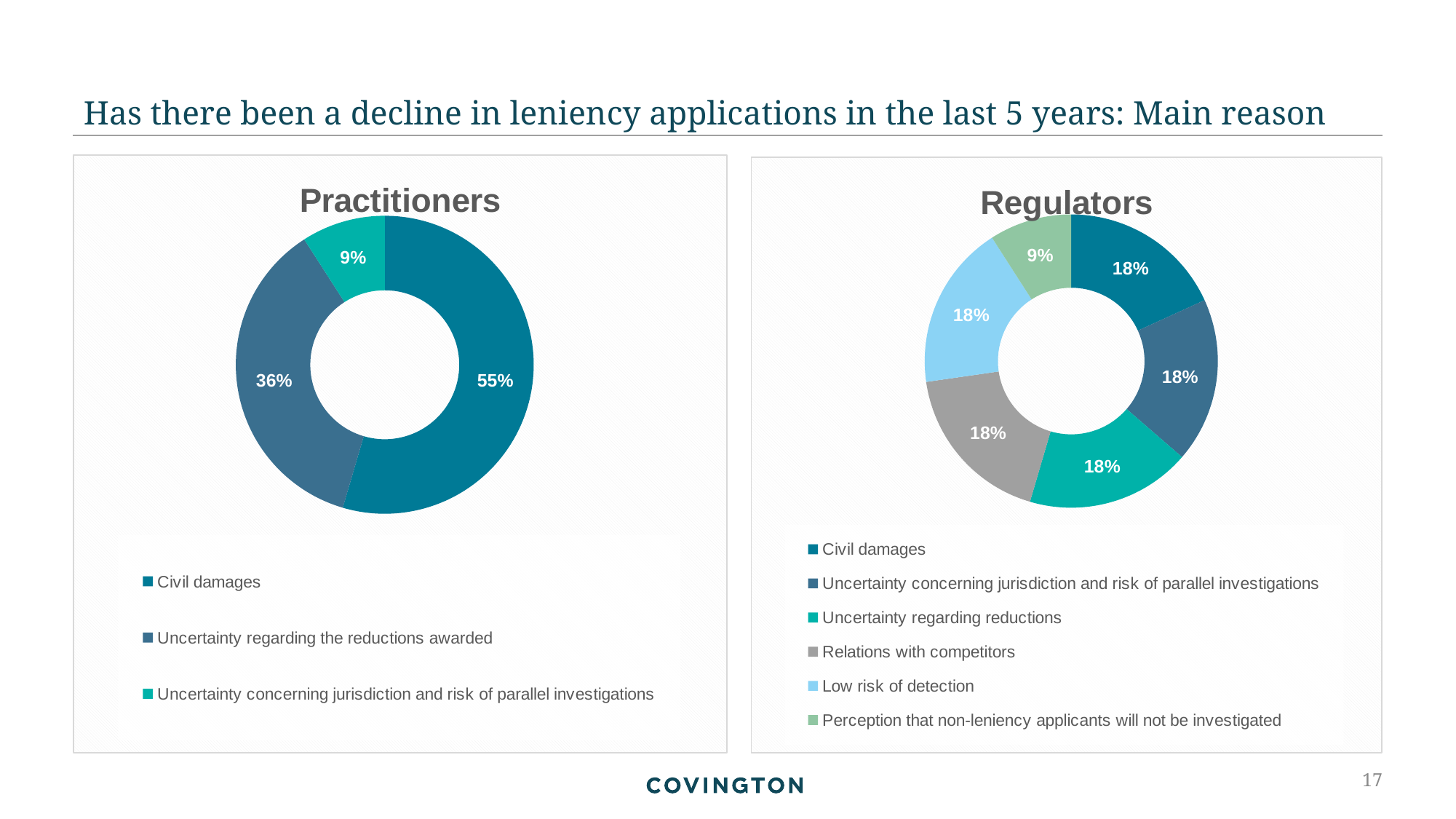
In the Practitioners chart, which reason has the largest share? Civil damages In the Practitioners chart, what share is attributed to Civil damages? 55% How many reasons does the legend of the Regulators chart list? 6 In the Practitioners chart, which reason has the smallest share? Uncertainty concerning jurisdiction and risk of parallel investigations In the Practitioners chart, what share is attributed to Uncertainty concerning jurisdiction and risk of parallel investigations? 9% In the Regulators chart, what share is attributed to Perception that non-leniency applicants will not be investigated? 9% In the Practitioners chart, what share is attributed to Uncertainty regarding the reductions awarded? 36% In the Practitioners chart, what is the difference in percentage points between Civil damages and Uncertainty regarding the reductions awarded? 19 percentage points In the Regulators chart, what share is attributed to Low risk of detection? 18% What type of chart is the Regulators chart? Doughnut (pie) chart In the Regulators chart, which reason has the smallest share? Perception that non-leniency applicants will not be investigated How many reasons does the legend of the Practitioners chart list? 3